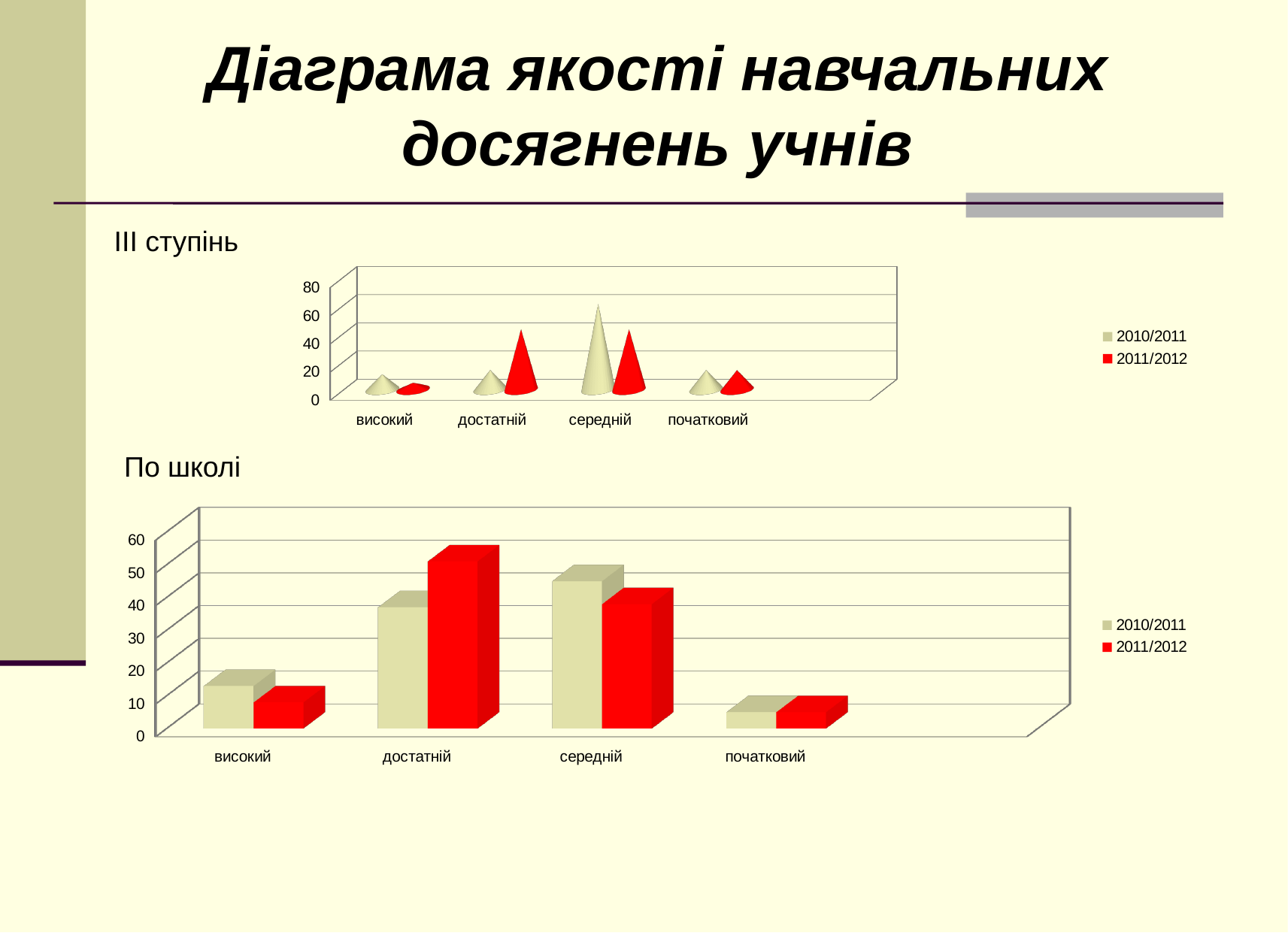
In the "По школі" chart, which category has the lowest value for the 2010/2011 series? початковий In the "По школі" chart, which category has the highest value for the 2011/2012 series? достатній In the "По школі" chart, is the 2010/2011 value for високий greater or less than 20? less How many series does the legend of the "ІІІ ступінь" chart list? 2 In the "По школі" chart, for the category достатній, which series has the larger value: 2010/2011 or 2011/2012? 2011/2012 What kind of chart is the "По школі" chart at the bottom of the slide? bar chart In the "ІІІ ступінь" chart, for the category достатній, which series has the larger value: 2010/2011 or 2011/2012? 2011/2012 What colour represents the 2011/2012 series in the charts on this slide? red How many categories are shown on the x axis of the "По школі" chart? 4 In the "ІІІ ступінь" chart, which category has the highest value for the 2010/2011 series? середній In the "По школі" chart, is the 2011/2012 value for достатній greater or less than 40? greater